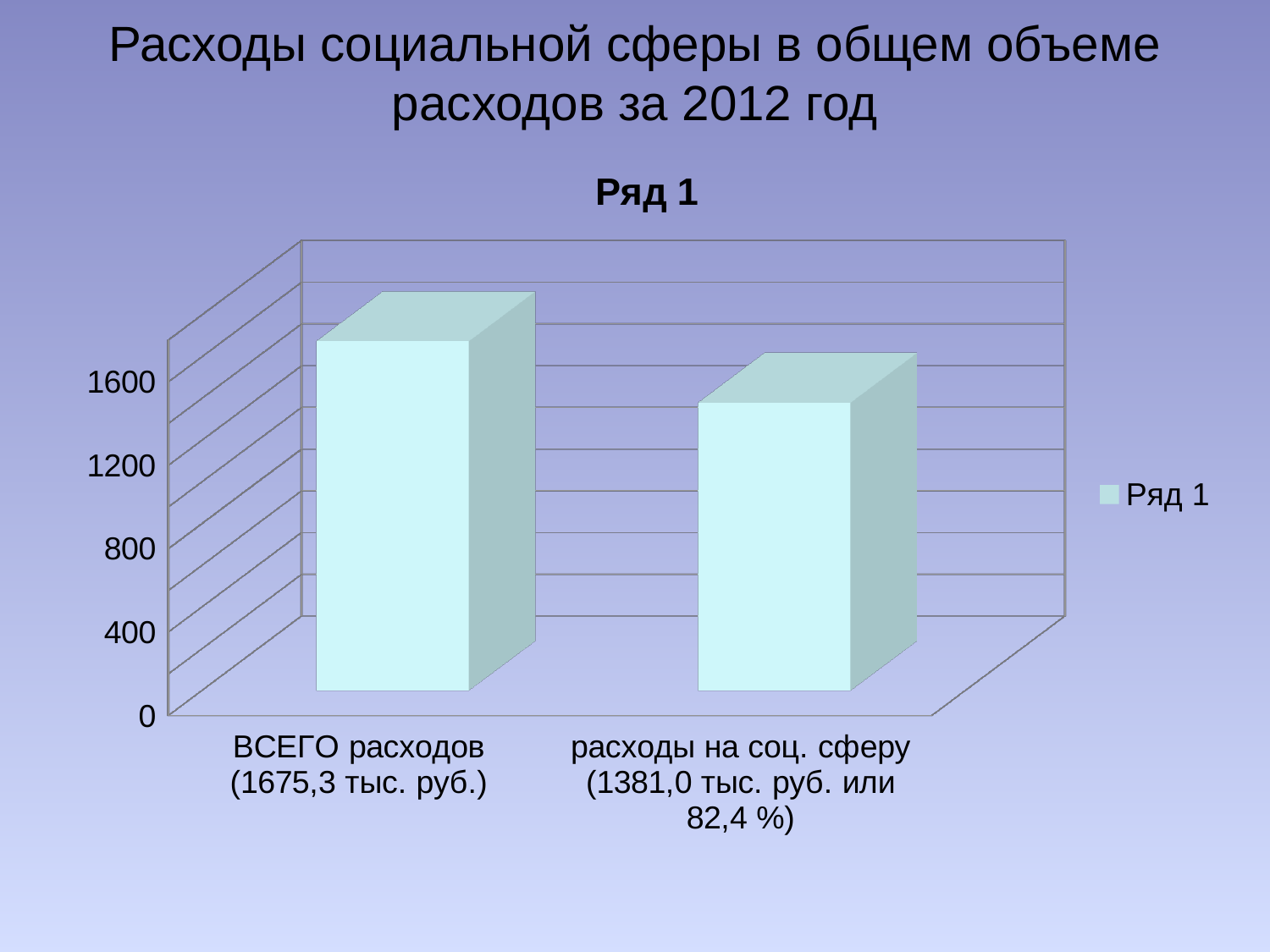
What is the value for ВСЕГО расходов? 1675,3 тыс. руб. What is the difference between ВСЕГО расходов and расходы на соц. сферу in тыс. руб.? 294,3 тыс. руб. What kind of chart is shown on the slide? bar chart What share of total expenses do расходы на соц. сферу make up, as printed on the slide? 82,4 % Which category has the lower bar? расходы на соц. сферу How many series does the legend list? 1 Is the value for ВСЕГО расходов greater or less than 1600? greater What is the value for расходы на соц. сферу? 1381,0 тыс. руб. Which category has the higher bar? ВСЕГО расходов How many bars are shown in the chart? 2 What is the name of the series shown in the legend? Ряд 1 Is the value for расходы на соц. сферу greater or less than 1200? greater